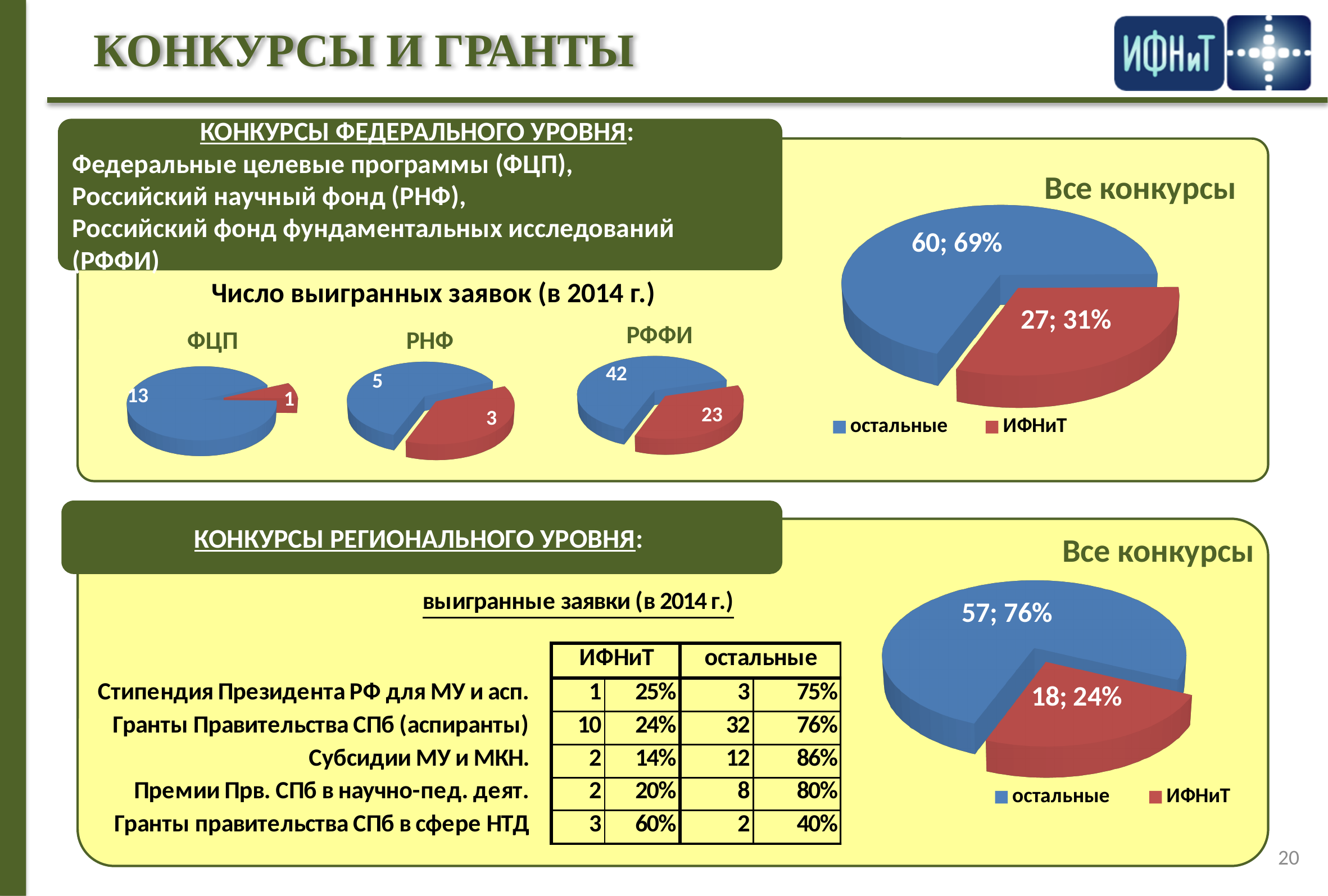
In the federal-level 'Все конкурсы' pie chart (top right), what share of the pie does the остальные slice have? 69% In the federal-level 'Все конкурсы' pie chart (top right), what colour is the ИФНиТ slice? red In the РФФИ pie chart, what is the value of the red (ИФНиТ) slice? 23 In the ФЦП pie chart, what is the value of the blue (остальные) slice? 13 What kind of chart is used for 'Все конкурсы' in the top right of the slide? pie chart In the regional-level 'Все конкурсы' pie chart (bottom right), what value is shown for the остальные slice? 57; 76% How many entries does the legend of the regional-level 'Все конкурсы' pie chart list? 2 In the regional-level 'Все конкурсы' pie chart (bottom right), what share of the pie does the ИФНиТ slice have? 24% In the РФФИ pie chart, what is the total of the two slices? 65 In the federal-level 'Все конкурсы' pie chart (top right), what value is shown for the ИФНиТ slice? 27; 31% In the РНФ pie chart, what is the difference between the blue slice and the red slice? 2 In the ФЦП pie chart, which slice is larger, the blue one or the red one? the blue one